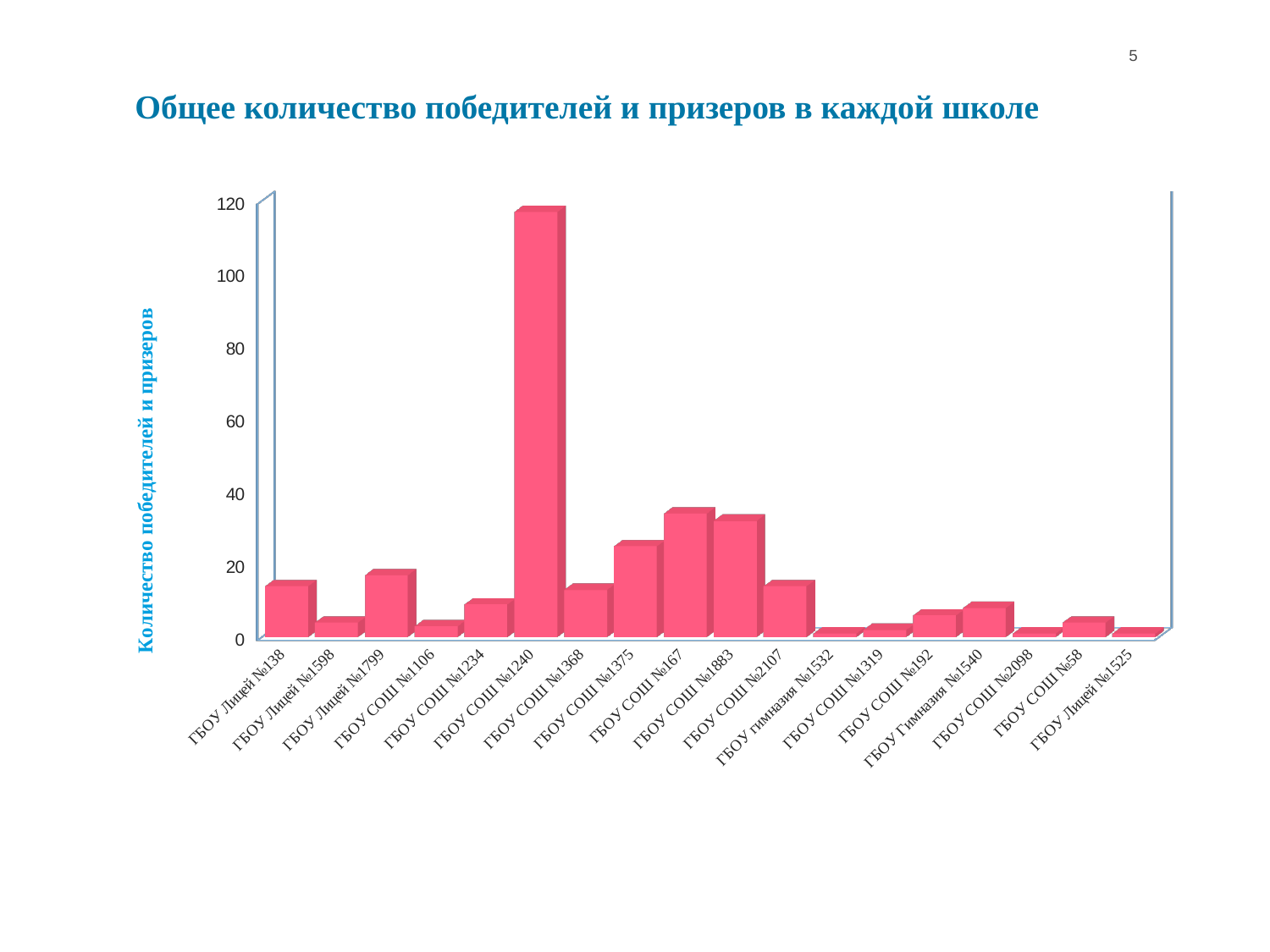
What is the title of the chart? Общее количество победителей и призеров в каждой школе Which school has the highest number of winners and prize-winners? ГБОУ СОШ №1240 Is the value for ГБОУ СОШ №1240 greater or less than 100? greater Is the value for ГБОУ Лицей №138 greater or less than 20? less What is the label on the vertical axis of the chart? Количество победителей и призеров Which has a larger value, ГБОУ СОШ №1240 or ГБОУ СОШ №167? ГБОУ СОШ №1240 Is the value for ГБОУ СОШ №2107 greater or less than 20? less How many schools are shown on the x axis of the chart? 18 Which has a larger value, ГБОУ СОШ №1375 or ГБОУ СОШ №1368? ГБОУ СОШ №1375 What kind of chart is shown on the slide? bar chart